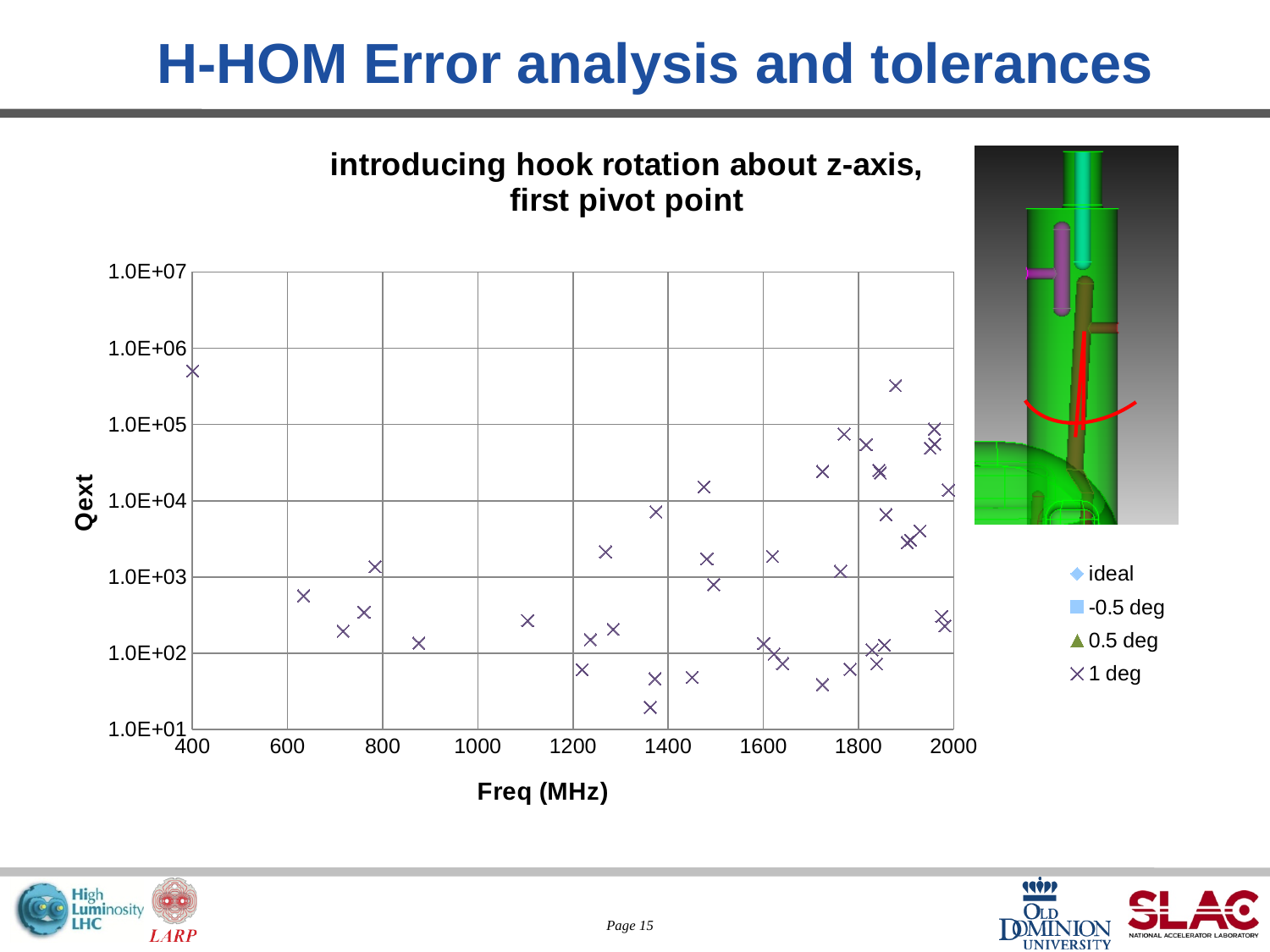
Is the Qext value of the lowest point near 1720 MHz greater or less than 1.0E+02? less Is the Qext value of the point plotted at about 400 MHz greater or less than 1.0E+05? greater How many series does the chart legend list? 4 What is the title of the chart? introducing hook rotation about z-axis, first pivot point Is the Qext value of the point plotted near 1100 MHz greater or less than 1.0E+02? greater Which legend series is plotted with an x marker? 1 deg What kind of chart is shown on the slide? scatter chart